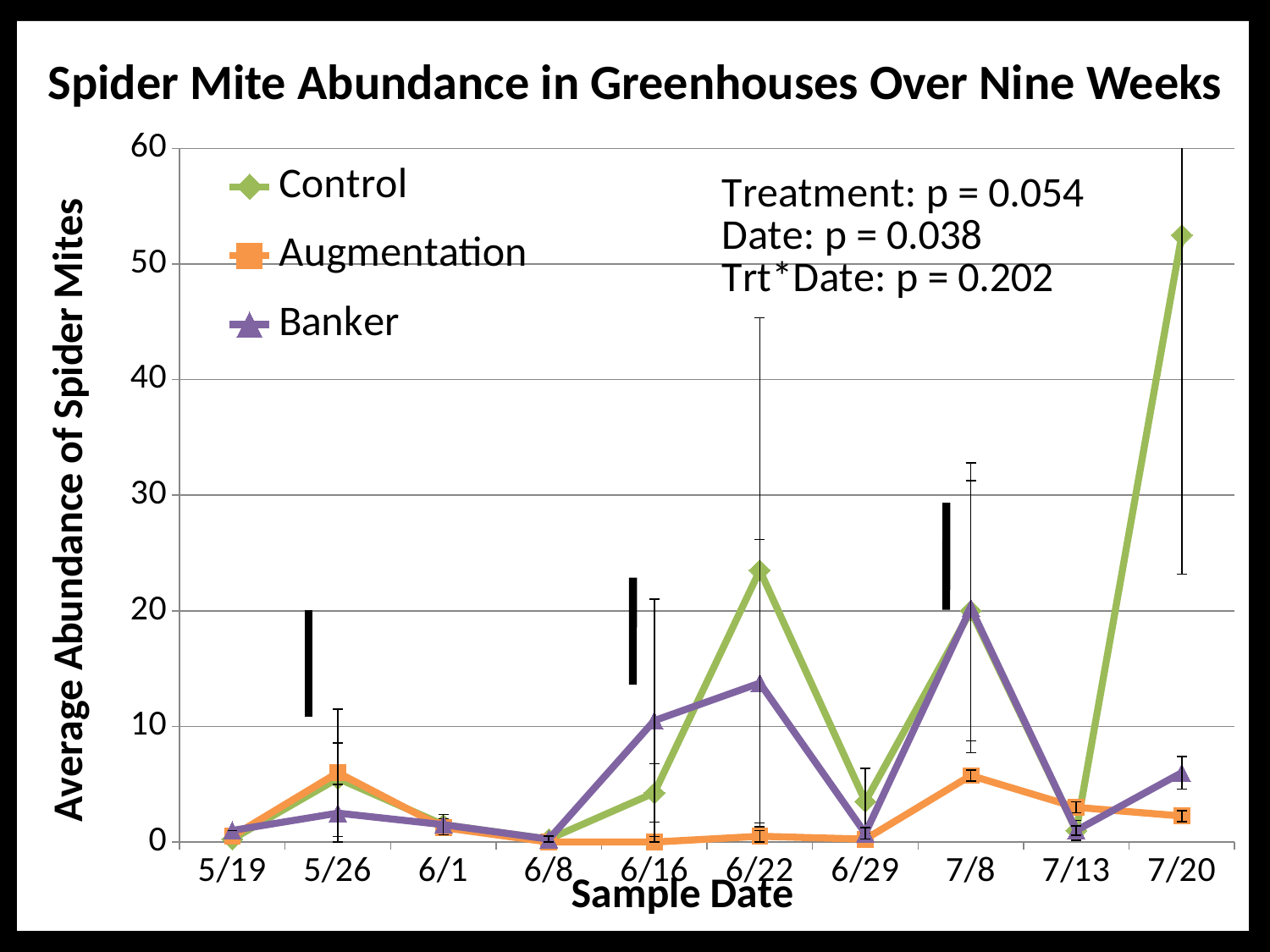
What kind of chart is shown on the slide? line chart How many sample dates are shown on the x axis? 10 Is the value for Augmentation on 7/8 greater or less than 10? less Which series has the highest value on 7/20? Control On 6/16, which series has the larger value, Banker or Augmentation? Banker On 6/22, which series has the larger value, Control or Banker? Control What is the title of the chart? Spider Mite Abundance in Greenhouses Over Nine Weeks Is the value for Control on 6/22 greater or less than 20? greater Is the value for Control on 7/20 greater or less than 50? greater On which sample date does the Control series reach its highest value? 7/20 How many series does the legend list? 3